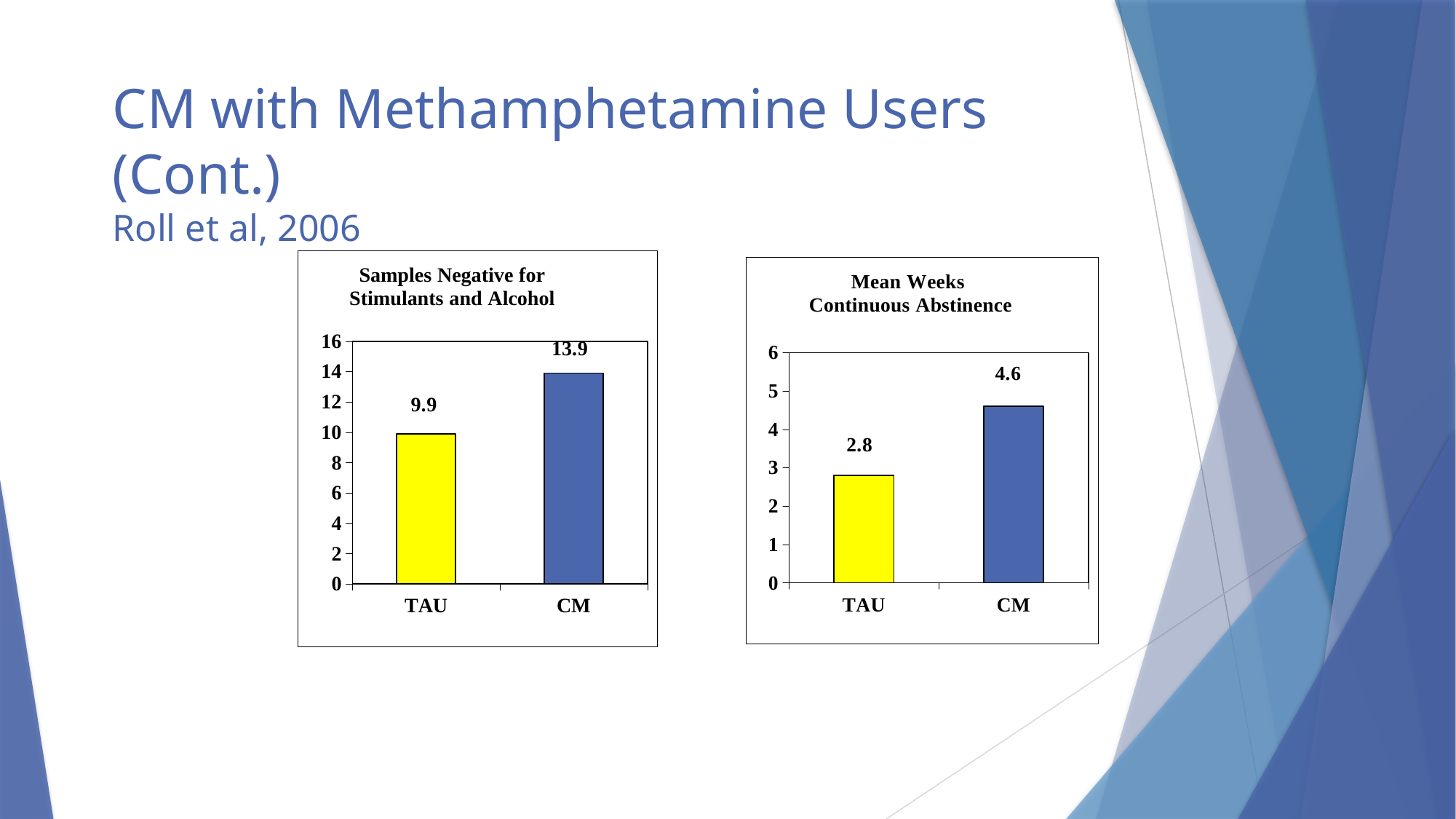
In the 'Mean Weeks Continuous Abstinence' chart, what is the difference between the CM and TAU values? 1.8 In the 'Mean Weeks Continuous Abstinence' chart, what is the value for TAU? 2.8 In the 'Samples Negative for Stimulants and Alcohol' chart, what is the value for TAU? 9.9 In the 'Samples Negative for Stimulants and Alcohol' chart, what is the value for CM? 13.9 In the 'Samples Negative for Stimulants and Alcohol' chart, what colour is the TAU bar? Yellow How many categories are shown in the 'Samples Negative for Stimulants and Alcohol' chart? 2 In the 'Mean Weeks Continuous Abstinence' chart, what is the value for CM? 4.6 In the 'Mean Weeks Continuous Abstinence' chart, which is larger, TAU or CM? CM In the 'Samples Negative for Stimulants and Alcohol' chart, what is the difference between the CM and TAU values? 4.0 What kind of chart is the 'Mean Weeks Continuous Abstinence' chart? Bar chart In the 'Mean Weeks Continuous Abstinence' chart, which category has the lowest value? TAU In the 'Samples Negative for Stimulants and Alcohol' chart, which category has the highest value? CM